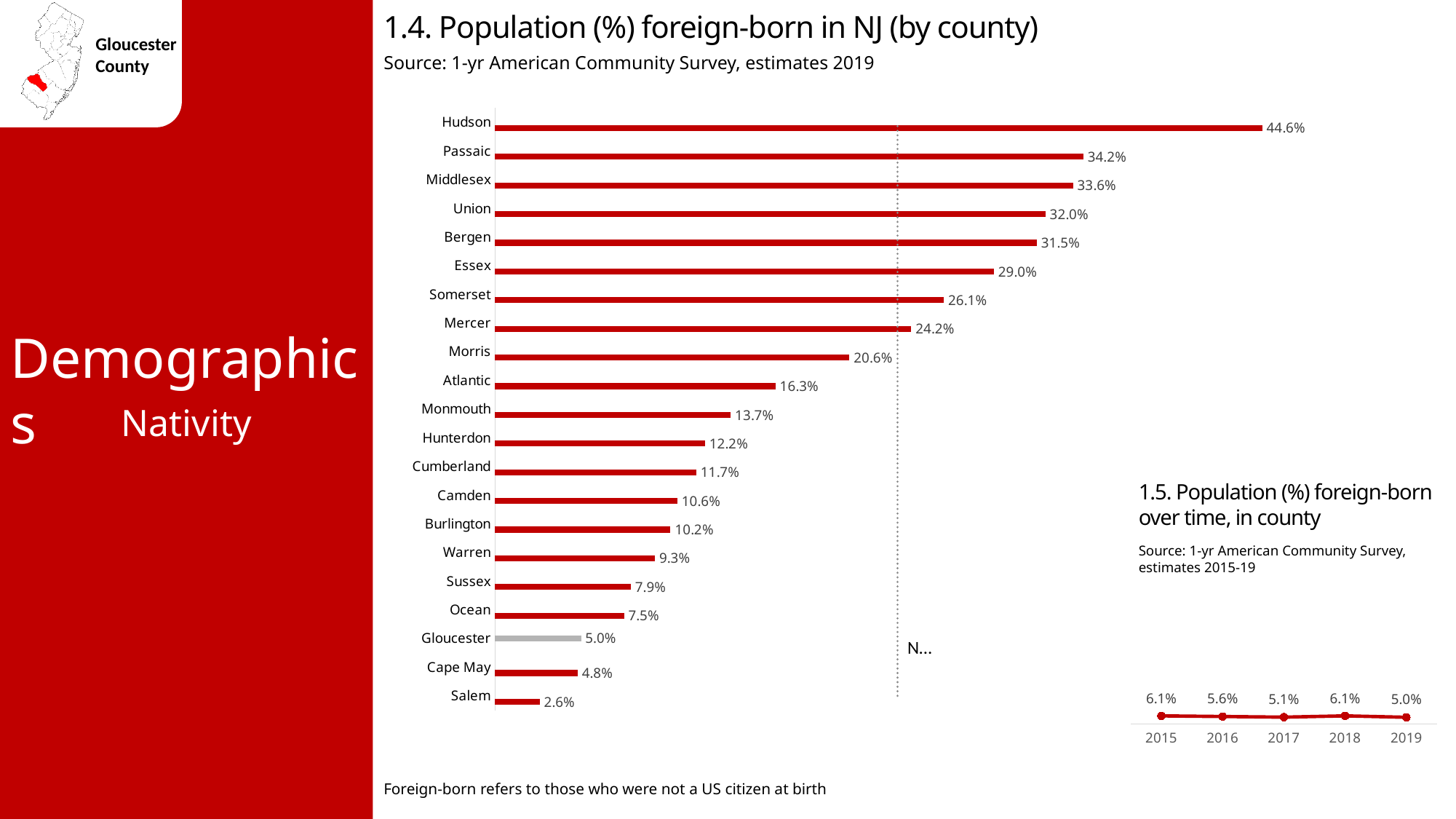
In the chart '1.4. Population (%) foreign-born in NJ (by county)', which county has the lowest value? Salem In the chart '1.5. Population (%) foreign-born over time, in county', how many years are plotted? 5 In the chart '1.4. Population (%) foreign-born in NJ (by county)', what is the value for Gloucester? 5.0% In the chart '1.4. Population (%) foreign-born in NJ (by county)', what is the difference between Hudson and Passaic? 10.4% What kind of chart is '1.4. Population (%) foreign-born in NJ (by county)'? Bar chart In the chart '1.5. Population (%) foreign-born over time, in county', what is the value for 2017? 5.1% In the chart '1.4. Population (%) foreign-born in NJ (by county)', which county has the highest value? Hudson In the chart '1.4. Population (%) foreign-born in NJ (by county)', what is the value for Bergen? 31.5% In the chart '1.4. Population (%) foreign-born in NJ (by county)', which county's bar is coloured grey instead of red? Gloucester In the chart '1.5. Population (%) foreign-born over time, in county', what is the difference between 2015 and 2019? 1.1% In the chart '1.4. Population (%) foreign-born in NJ (by county)', how many counties are shown? 21 In the chart '1.4. Population (%) foreign-born in NJ (by county)', which is larger, Camden or Burlington? Camden